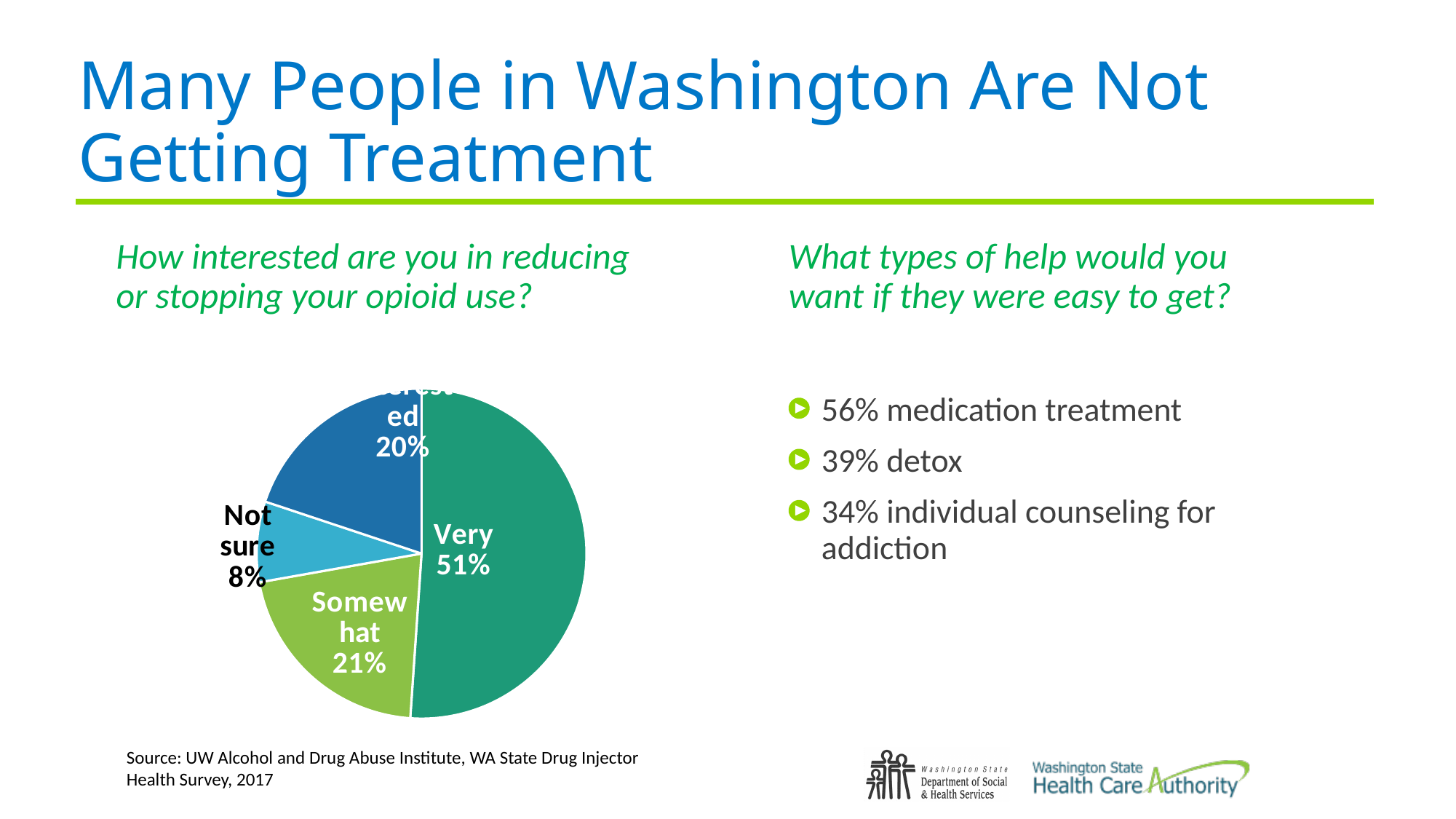
What kind of chart is shown on the slide? pie chart What share of the pie chart is the "Very" slice? 51% Which slice of the pie chart is the smallest? Not sure Is the "Very" slice of the pie chart greater or less than 50%? greater What is the difference in percentage points between the "Very" and "Somewhat" slices? 30 Which slice of the pie chart is the largest? Very What share of the pie chart is the "Somewhat" slice? 21% What share of the pie chart is the "Not sure" slice? 8% Which is larger in the pie chart, the "Somewhat" slice or the "Not sure" slice? Somewhat What is the difference in percentage points between the "Somewhat" and "Not sure" slices? 13 What survey question does the pie chart answer? How interested are you in reducing or stopping your opioid use? How many slices does the pie chart have? 4